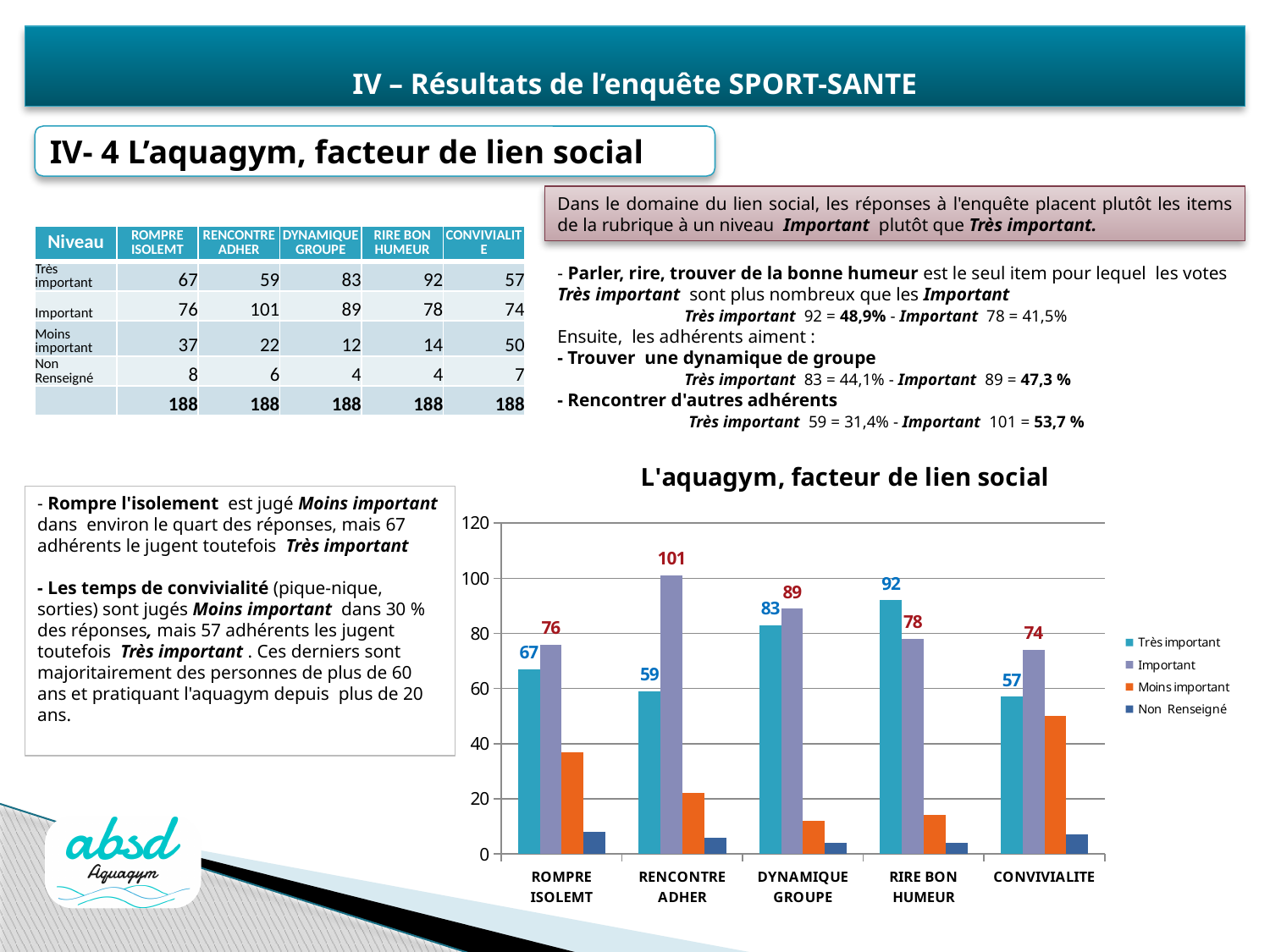
In the chart 'L'aquagym, facteur de lien social', for DYNAMIQUE GROUPE, which is larger: 'Très important' or 'Important'? Important In the chart 'L'aquagym, facteur de lien social', is the 'Moins important' value for DYNAMIQUE GROUPE greater or less than 20? less In the chart 'L'aquagym, facteur de lien social', which category has the highest 'Important' value? RENCONTRE ADHER In the chart 'L'aquagym, facteur de lien social', what is the difference between 'Très important' and 'Important' for RIRE BON HUMEUR? 14 How many categories are shown on the x axis of the chart 'L'aquagym, facteur de lien social'? 5 In the chart 'L'aquagym, facteur de lien social', what is the value of 'Très important' for ROMPRE ISOLEMT? 67 In the chart 'L'aquagym, facteur de lien social', which category has the lowest 'Très important' value? CONVIVIALITE What kind of chart is 'L'aquagym, facteur de lien social'? bar chart In the chart 'L'aquagym, facteur de lien social', is the 'Moins important' value for CONVIVIALITE greater or less than 40? greater In the chart 'L'aquagym, facteur de lien social', what is the value of 'Très important' for RIRE BON HUMEUR? 92 How many series does the legend of the chart 'L'aquagym, facteur de lien social' list? 4 In the chart 'L'aquagym, facteur de lien social', what is the value of 'Important' for RENCONTRE ADHER? 101